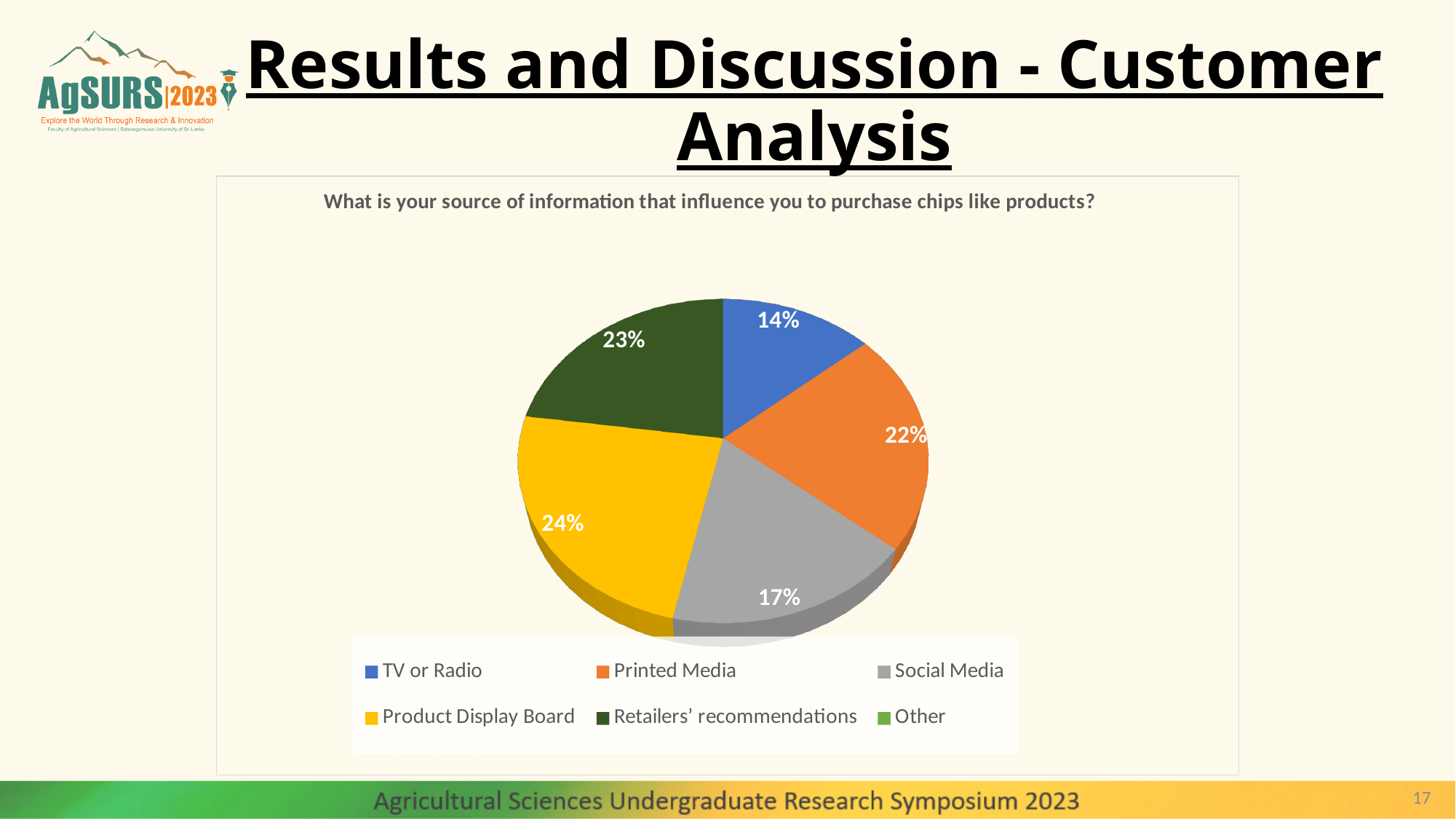
What type of chart is shown on the slide? pie chart Which labelled slice of the pie is the smallest? TV or Radio Which source of information has the largest share of the pie? Product Display Board How many entries does the legend list? 6 What percentage is shown for Retailers' recommendations? 23% Which has a larger share, Retailers' recommendations or TV or Radio? Retailers' recommendations What percentage is shown for Social Media? 17% What percentage is shown for Product Display Board? 24% What is the difference in percentage points between Printed Media and Social Media? 5 What share of the pie is Printed Media? 22% What percentage of respondents chose TV or Radio as their source of information? 14% What colour is the Product Display Board slice? yellow